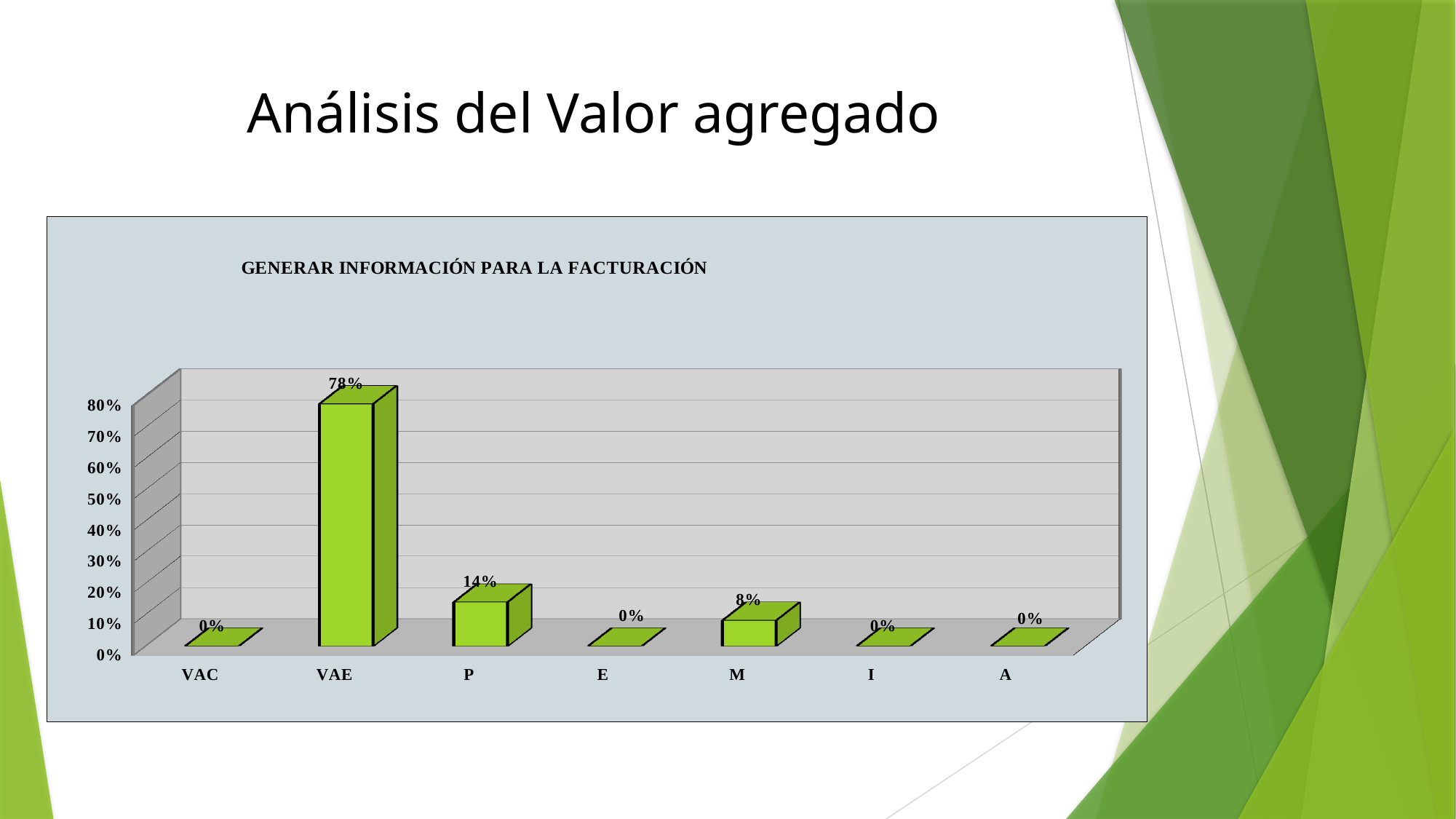
What is the value for P? 14% What is the difference between the values for VAE and P? 64% What is the title of the chart? GENERAR INFORMACIÓN PARA LA FACTURACIÓN What is the value for M? 8% What is the difference between the values for P and M? 6% How many categories are shown on the x axis? 7 Which is larger, the value for P or the value for M? P What is the value for VAE? 78% What is the value for VAC? 0% Is the value for VAE greater or less than 70%? greater Which category has the highest value? VAE What kind of chart is shown on the slide? bar chart